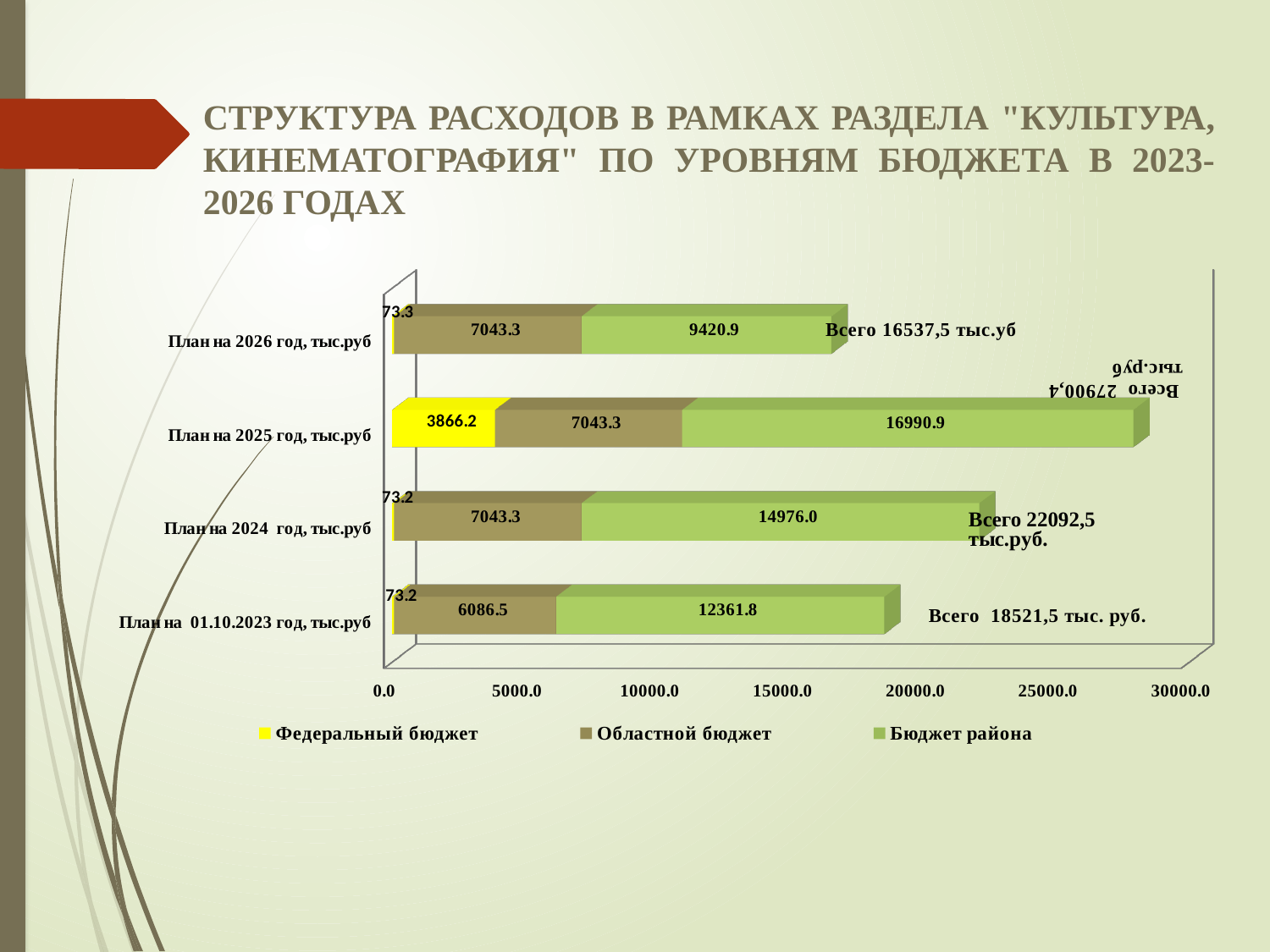
What is the value of Областной бюджет for План на 01.10.2023 год, тыс.руб? 6086.5 What is the difference between the Бюджет района values for План на 2025 год and План на 2024 год? 2014.9 What is the value of Федеральный бюджет for План на 2025 год, тыс.руб? 3866.2 Which category has the lowest value for Бюджет района? План на 2026 год, тыс.руб What is the value of Бюджет района for План на 2024 год, тыс.руб? 14976.0 What is the value of Бюджет района for План на 2025 год, тыс.руб? 16990.9 What type of chart is shown on the slide? stacked bar chart What total is printed next to the bar for План на 2024 год, тыс.руб? Всего 22092,5 тыс.руб. Which is larger: Областной бюджет for План на 2024 год or for План на 01.10.2023 год? План на 2024 год, тыс.руб Which category has the highest value for Бюджет района? План на 2025 год, тыс.руб How many series does the legend list? 3 How many categories (plan years) are shown on the chart? 4